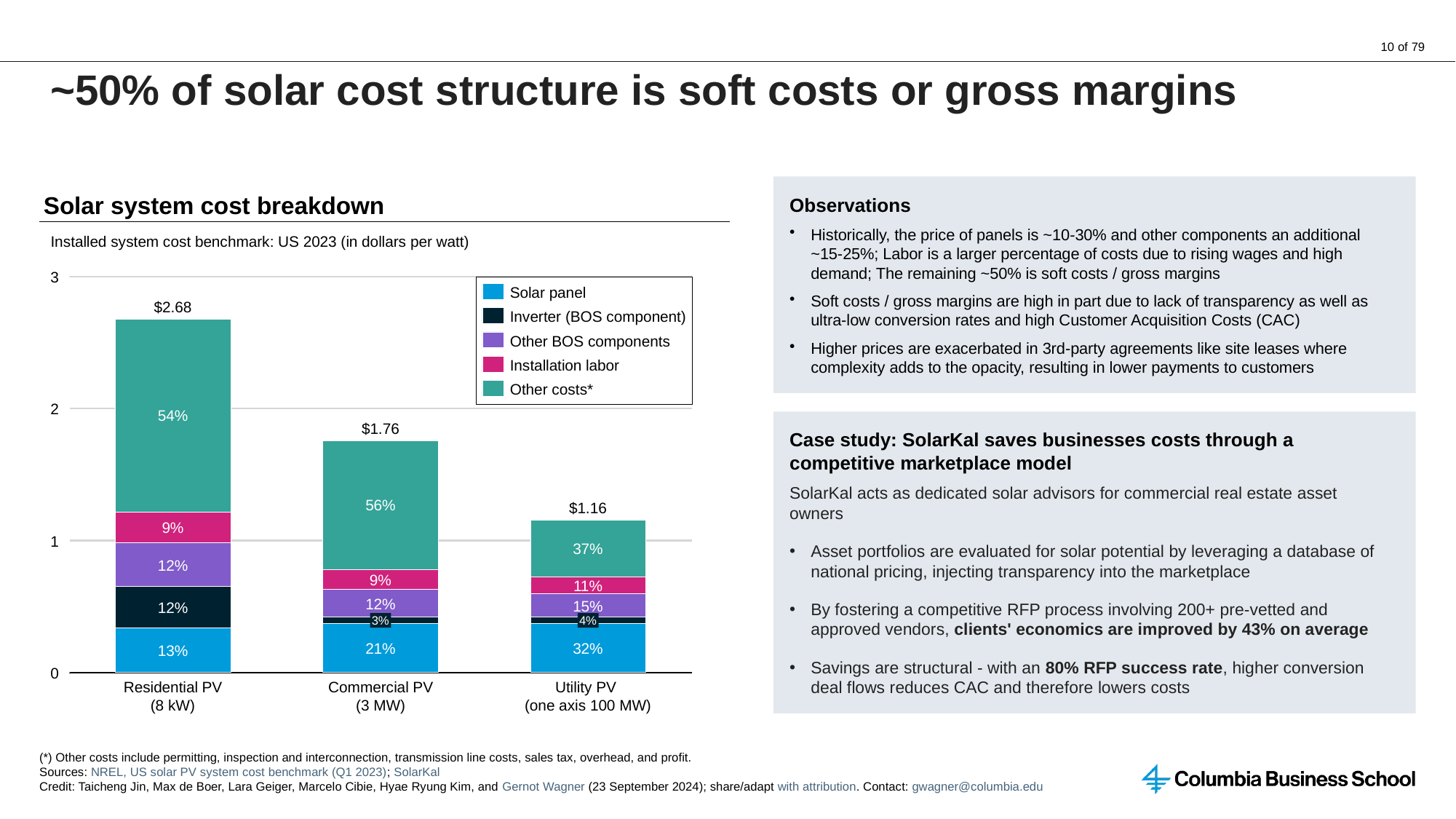
Do the total installed system costs rise or fall from Residential PV to Utility PV along the x axis? Fall What is the total installed system cost for Residential PV (8 kW)? $2.68 Which category has the highest total installed system cost? Residential PV (8 kW) What share of the Residential PV (8 kW) cost is Installation labor? 9% What share of the Commercial PV (3 MW) cost is Other costs*? 56% How many series does the legend list? 5 What kind of chart is shown on the slide? Stacked bar chart Is the total cost for Residential PV (8 kW) greater or less than 2? greater What share of the Utility PV (one axis 100 MW) cost is Solar panel? 32% Which category has the lowest total installed system cost? Utility PV (one axis 100 MW) What is the difference between the total cost of Residential PV (8 kW) and Utility PV (one axis 100 MW)? $1.52 What is the total installed system cost for Utility PV (one axis 100 MW)? $1.16